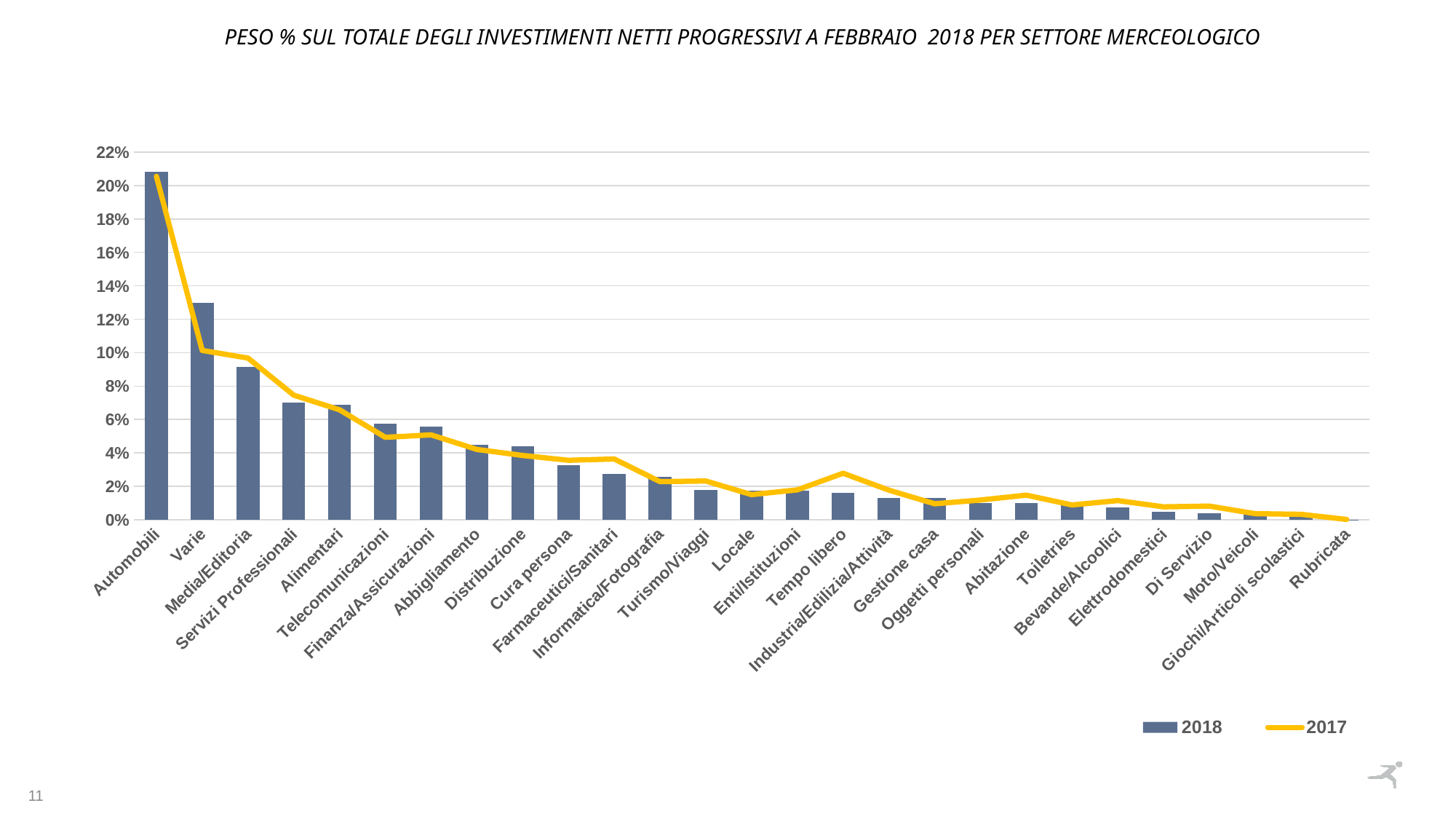
Which sector has the lowest 2018 value? Rubricata Which series is drawn as a yellow line? 2017 How many series does the legend list? 2 Which sector has the highest 2018 value? Automobili Which has the larger 2018 value, Varie or Media/Editoria? Varie Is the 2018 value for Automobili greater or less than 20%? greater Do the 2018 values generally rise or fall from left to right along the x axis? fall What kind of chart is shown on the slide? A bar chart with a line series Is the 2018 value for Cura persona greater or less than 4%? less Is the 2018 value for Varie greater or less than 12%? greater